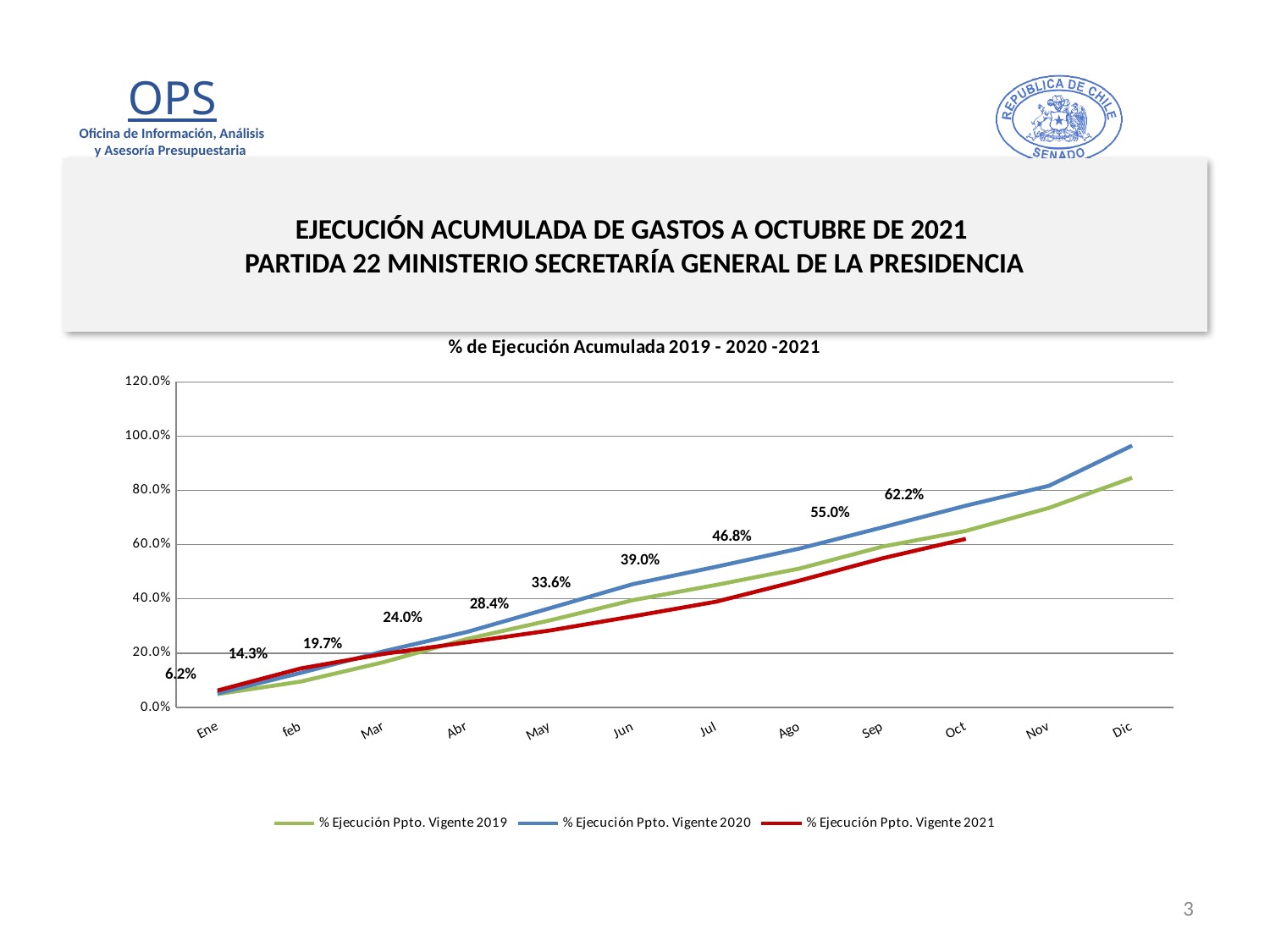
Do the values for % Ejecución Ppto. Vigente 2021 rise or fall from Ene to Oct? Rise What is the value for % Ejecución Ppto. Vigente 2021 in Ene? 6.2% Which month has the highest labelled value for % Ejecución Ppto. Vigente 2021? Oct What is the value for % Ejecución Ppto. Vigente 2021 in Oct? 62.2% What type of chart is shown on the slide? Line chart How many months are shown along the x axis? 12 What is the difference between the 2021 values for Ago and Jul? 7.8% What is the difference between the 2021 values for Oct and Sep? 7.2% What is the value for % Ejecución Ppto. Vigente 2021 in Jun? 33.6% In Dic, which series is higher: % Ejecución Ppto. Vigente 2020 or % Ejecución Ppto. Vigente 2019? % Ejecución Ppto. Vigente 2020 How many series does the legend list? 3 Is the value for % Ejecución Ppto. Vigente 2020 in Dic greater or less than 80.0%? greater